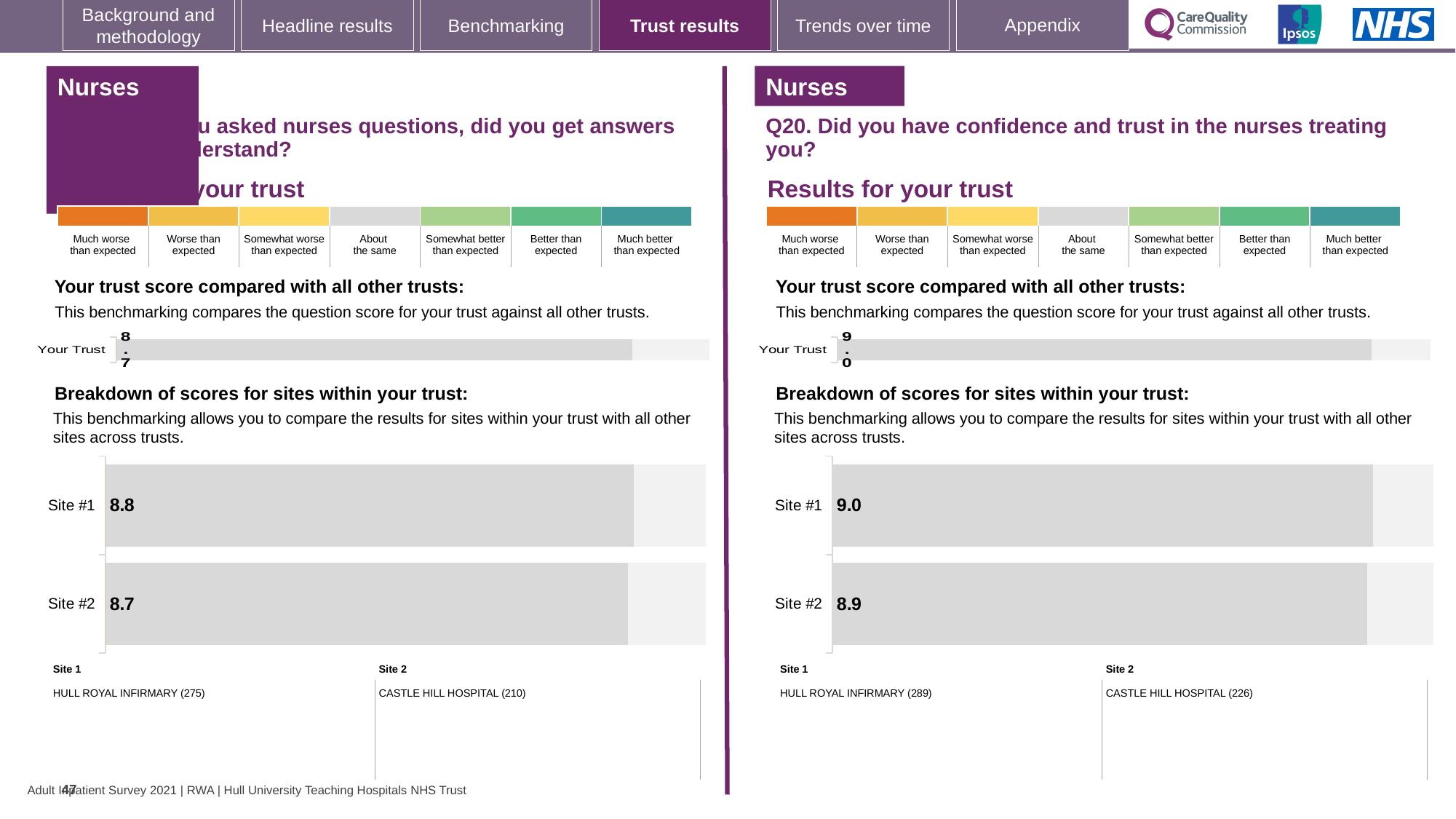
On the left-hand chart of site scores, which site has the lower score? Site #2 On the right-hand (Q20) chart of site scores, what is the score for Site #2? 8.9 On the left-hand 'Your Trust' bar chart, what is the trust score shown? 8.7 On the right-hand (Q20) chart of site scores, what is the difference between the Site #1 and Site #2 scores? 0.1 How many sites are shown on the left-hand chart of site scores? 2 On the left-hand chart of site scores, what is the score for Site #1? 8.8 On the right-hand (Q20) chart of site scores, what is the score for Site #1? 9.0 On the right-hand (Q20) 'Your Trust' bar chart, what is the trust score shown? 9.0 On the right-hand (Q20) side, which hospital is listed as Site 2? CASTLE HILL HOSPITAL (226) On the right-hand (Q20) chart of site scores, which site has the higher score? Site #1 On the left-hand chart of site scores, what is the score for Site #2? 8.7 What type of chart is used to show the site scores on the right-hand (Q20) side of the slide? Bar chart